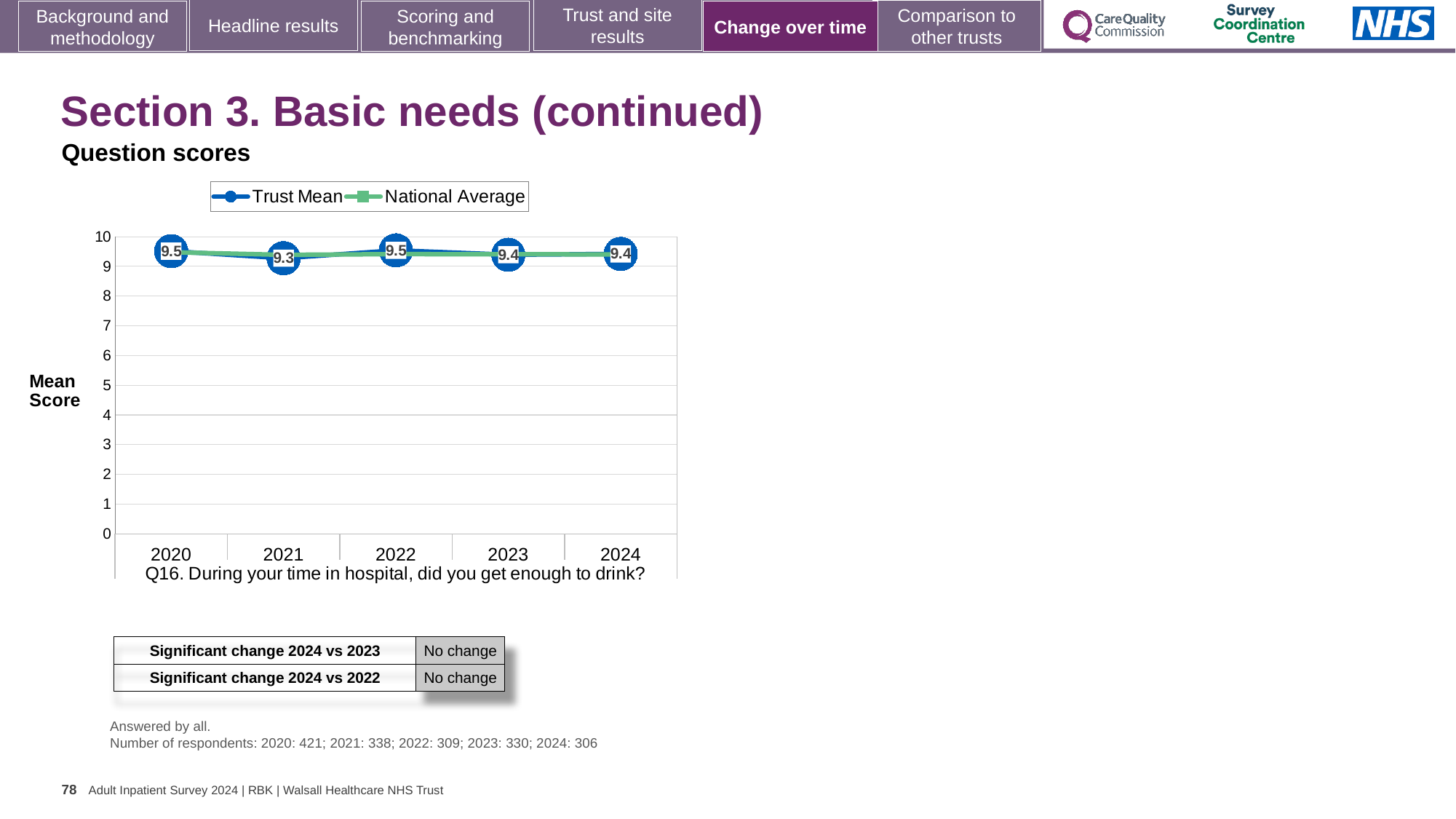
What is the Trust Mean score for 2020? 9.5 Which year has the higher Trust Mean score, 2021 or 2022? 2022 What is the difference between the Trust Mean scores for 2020 and 2021? 0.2 Which survey question does the chart relate to? Q16. During your time in hospital, did you get enough to drink? How many series does the chart legend list? 2 What is the Trust Mean score for 2021? 9.3 What are the two series named in the chart legend? Trust Mean and National Average How many years are shown on the x axis of the chart? 5 Is the National Average value for 2023 greater or less than 5? greater In which year is the Trust Mean score lowest? 2021 What is the Trust Mean score for 2024? 9.4 What kind of chart is shown on the slide? Line chart